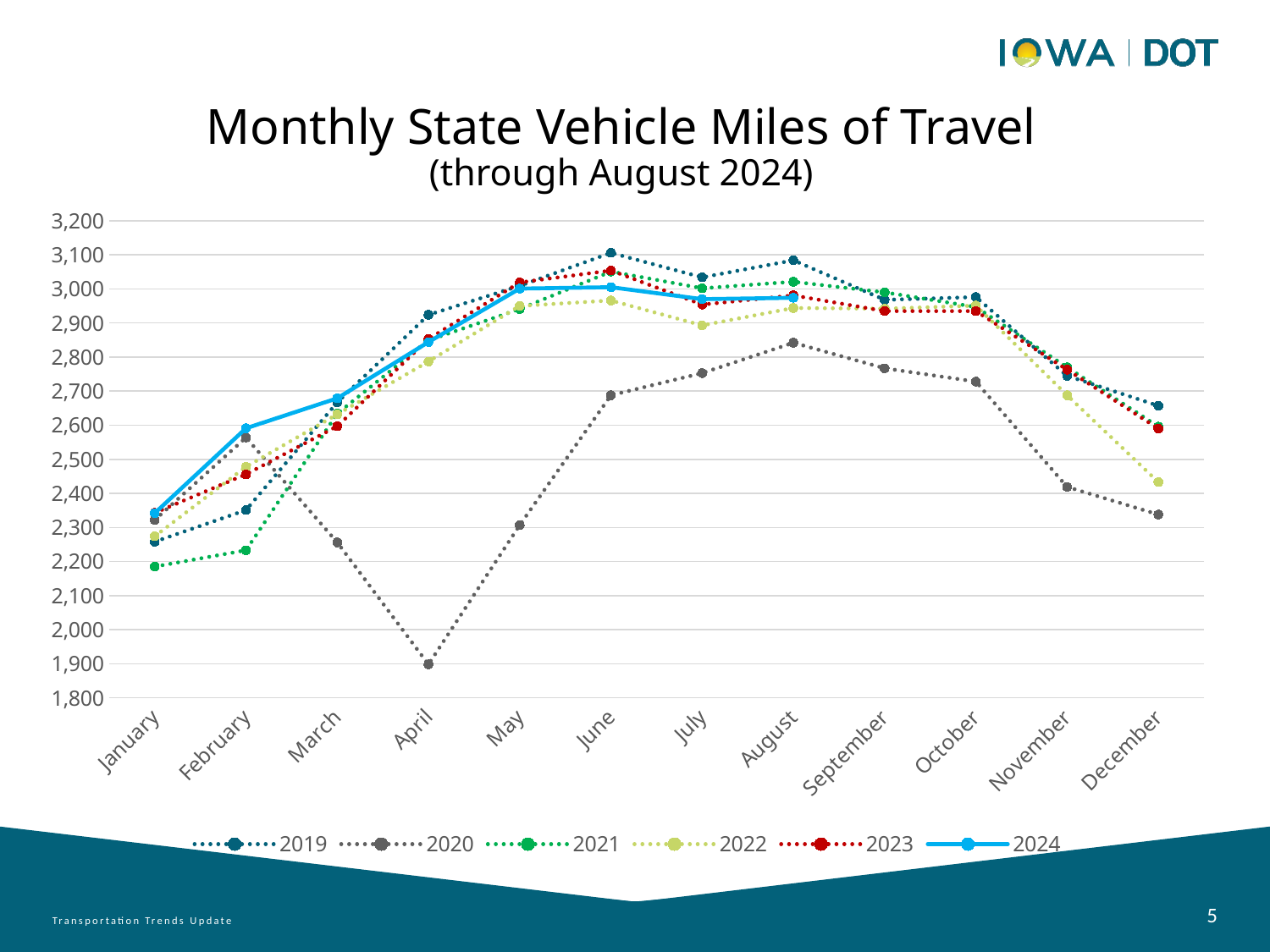
Does the 2020 series rise or fall from January to April? fall Which series has the lowest value in April? 2020 How many series does the legend list? 6 Which is larger in April, the value for 2019 or the value for 2020? 2019 What kind of chart is shown on the slide? line chart Is the value for 2020 in April greater or less than 2,000? less In which month does the 2020 series reach its lowest value? April Which series has the highest value in June? 2019 Is the value for 2019 in June greater or less than 3,000? greater Which series is drawn as a solid line rather than a dotted line? 2024 How many months are shown along the x axis? 12